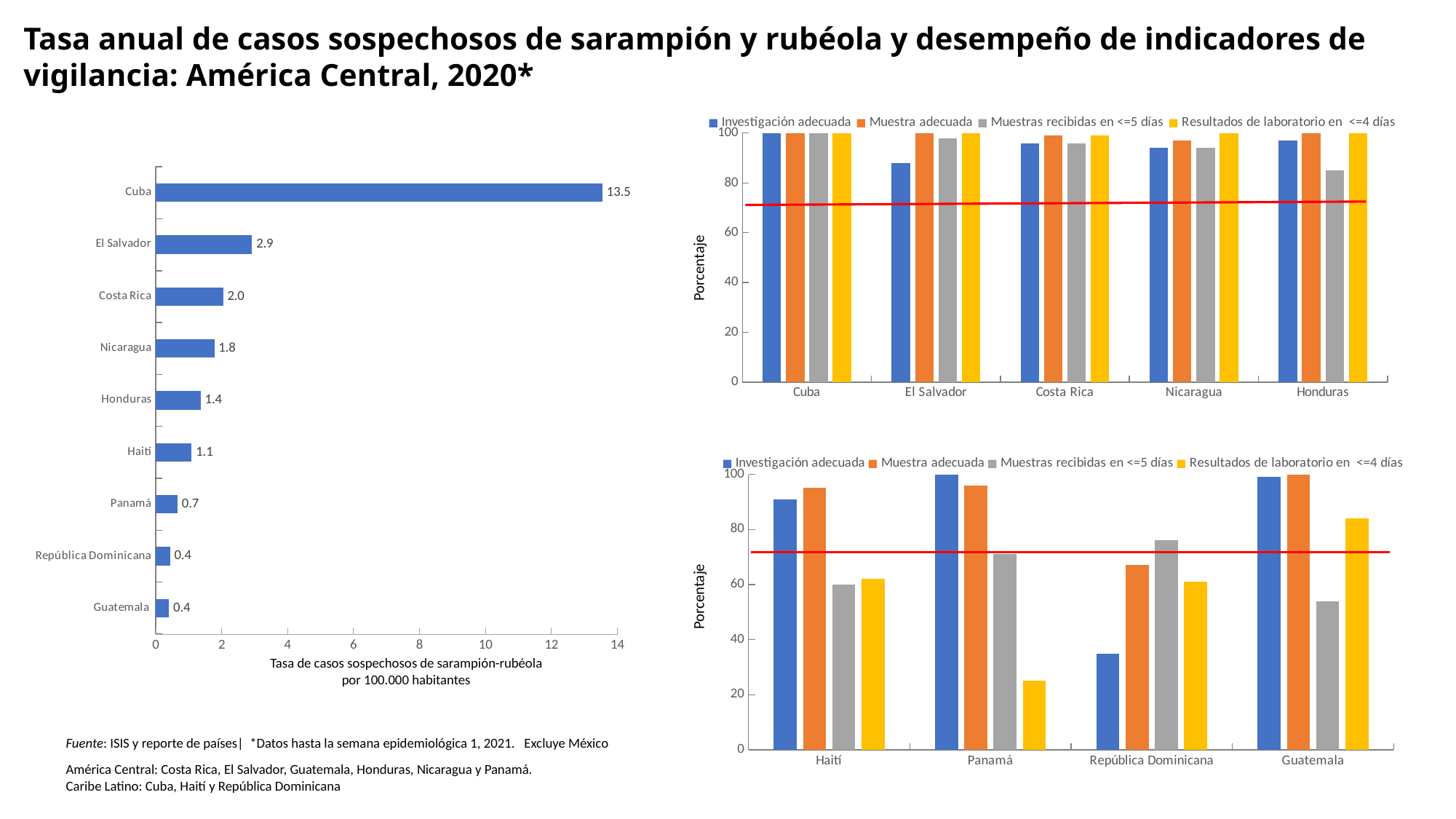
In the left bar chart, which country has the highest rate of suspected cases? Cuba How many series does the legend of the top-right chart list? 4 In the bottom-right chart, is the value of Resultados de laboratorio en <=4 días for Panamá greater or less than 40? less In the bottom-right chart, is the value of Investigación adecuada for República Dominicana greater or less than 60? less In the left bar chart, what is the difference between the values for Cuba and El Salvador? 10.6 In the left bar chart, which has the larger value, Honduras or Haití? Honduras In the top-right chart, is the value of Investigación adecuada for El Salvador greater or less than 80? greater In the left bar chart, what is the suspected measles-rubella case rate for Cuba? 13.5 How many countries are shown on the x axis of the bottom-right chart? 4 In the left bar chart, what is the value shown for Nicaragua? 1.8 What kind of chart is the chart on the left of the slide? Bar chart How many countries are shown in the left bar chart? 9